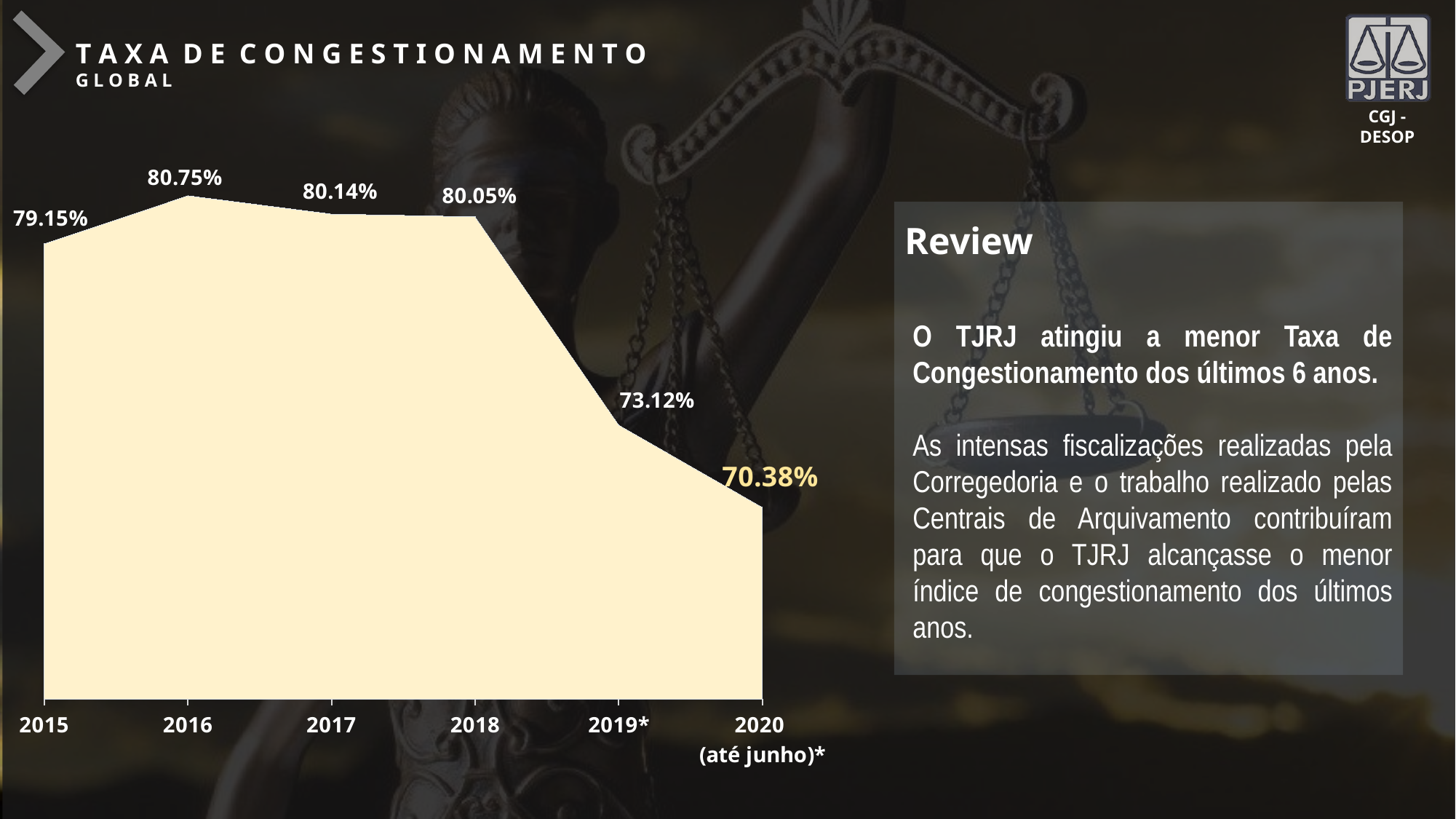
Which is larger, the value for 2017 or the value for 2019*? 2017 Which year has the lowest Taxa de Congestionamento? 2020 (até junho)* Which year has the highest Taxa de Congestionamento? 2016 What is the Taxa de Congestionamento value for 2018? 80.05% How many years are plotted on the chart? 6 What is the title of the chart on the slide? Taxa de Congestionamento Global What is the Taxa de Congestionamento value for 2020 (até junho)*? 70.38% What kind of chart is shown on the slide? Area chart What is the difference between the 2016 value and the 2015 value? 1.60% What is the Taxa de Congestionamento value for 2015? 79.15% Do the values rise or fall from 2018 to 2020 (até junho)*? Fall What is the difference between the 2019* value and the 2020 (até junho)* value? 2.74%